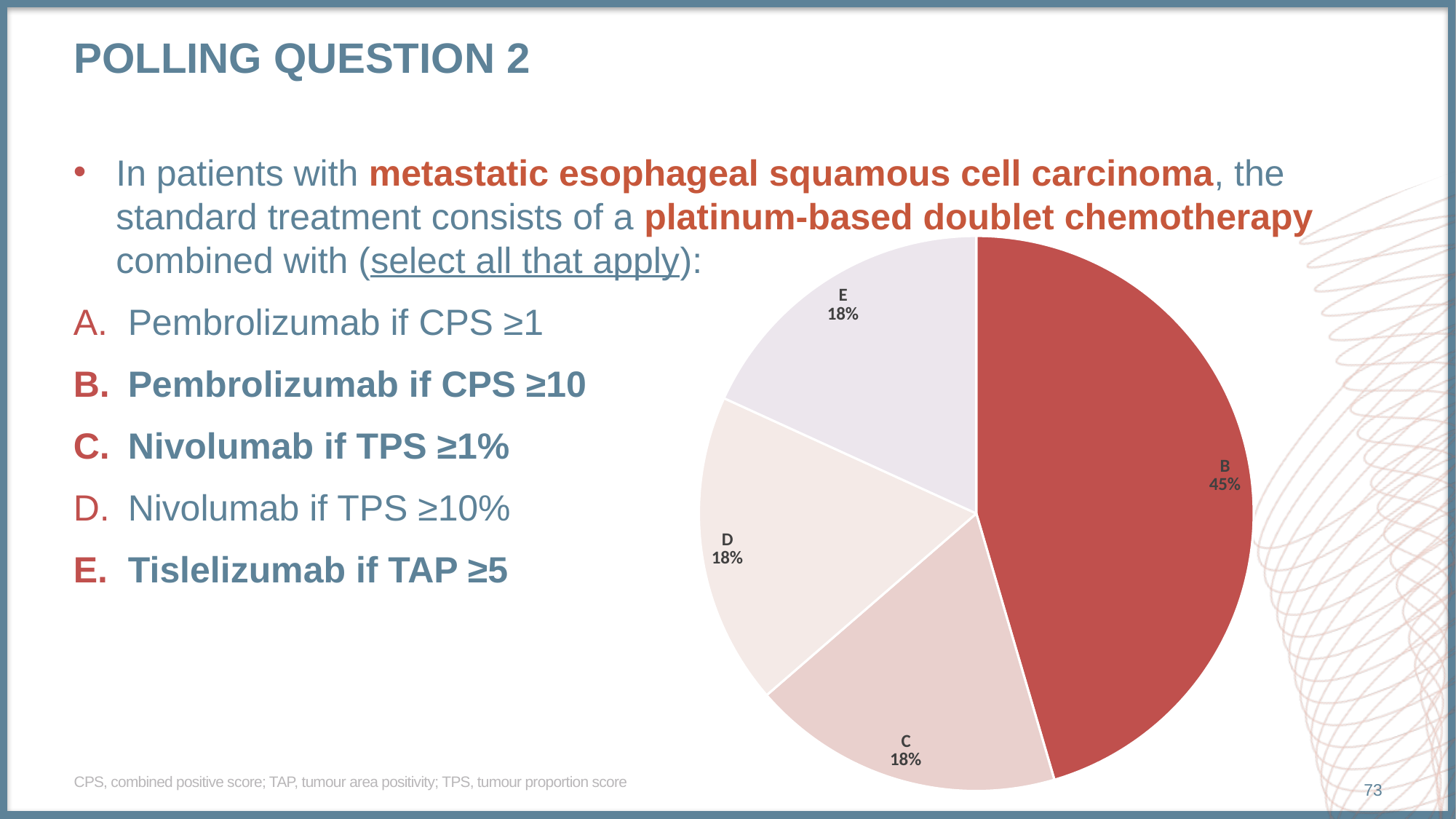
What kind of chart is shown on the slide? pie chart Which option has the largest slice of the pie? B What share of the pie does option B have? 45% What colour is the slice for option B? red What is the value shown for option D? 18% Which is larger, the slice for B or the slice for D? B How many slices does the pie chart have? 4 What share of the pie does option E have? 18% Which option from the list does not appear as a slice in the pie chart? A What is the difference between the share for B and the share for C? 27% What share of the pie does option C have? 18% What is the combined share of slices C, D and E? 54%